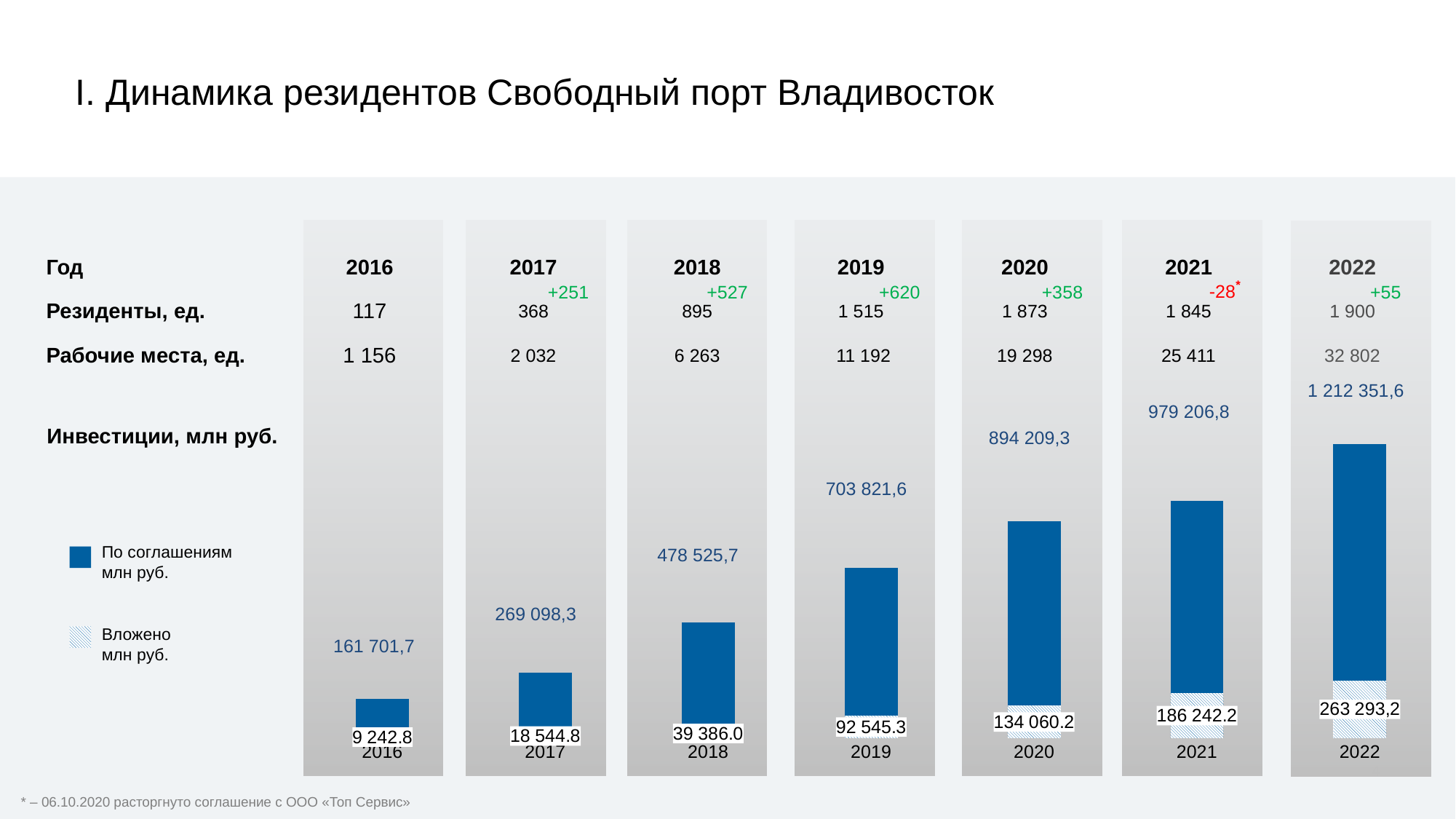
What is the value of 'Вложено' for 2016? 9 242.8 What kind of chart is shown on the slide? bar chart Which is larger: the 'По соглашениям' value for 2018 or for 2017? 2018 What is the difference between the 'По соглашениям' values for 2020 and 2019? 190 387,7 What is the value of 'Вложено' for 2020? 134 060.2 How many years are plotted on the chart? 7 Do the 'По соглашениям' values rise or fall from 2016 to 2022? rise What is the value of 'По соглашениям' for 2019? 703 821,6 Which year has the highest 'По соглашениям' value? 2022 Which year has the lowest 'Вложено' value? 2016 What is the value of 'По соглашениям' for 2022? 1 212 351,6 How many series does the chart legend list? 2